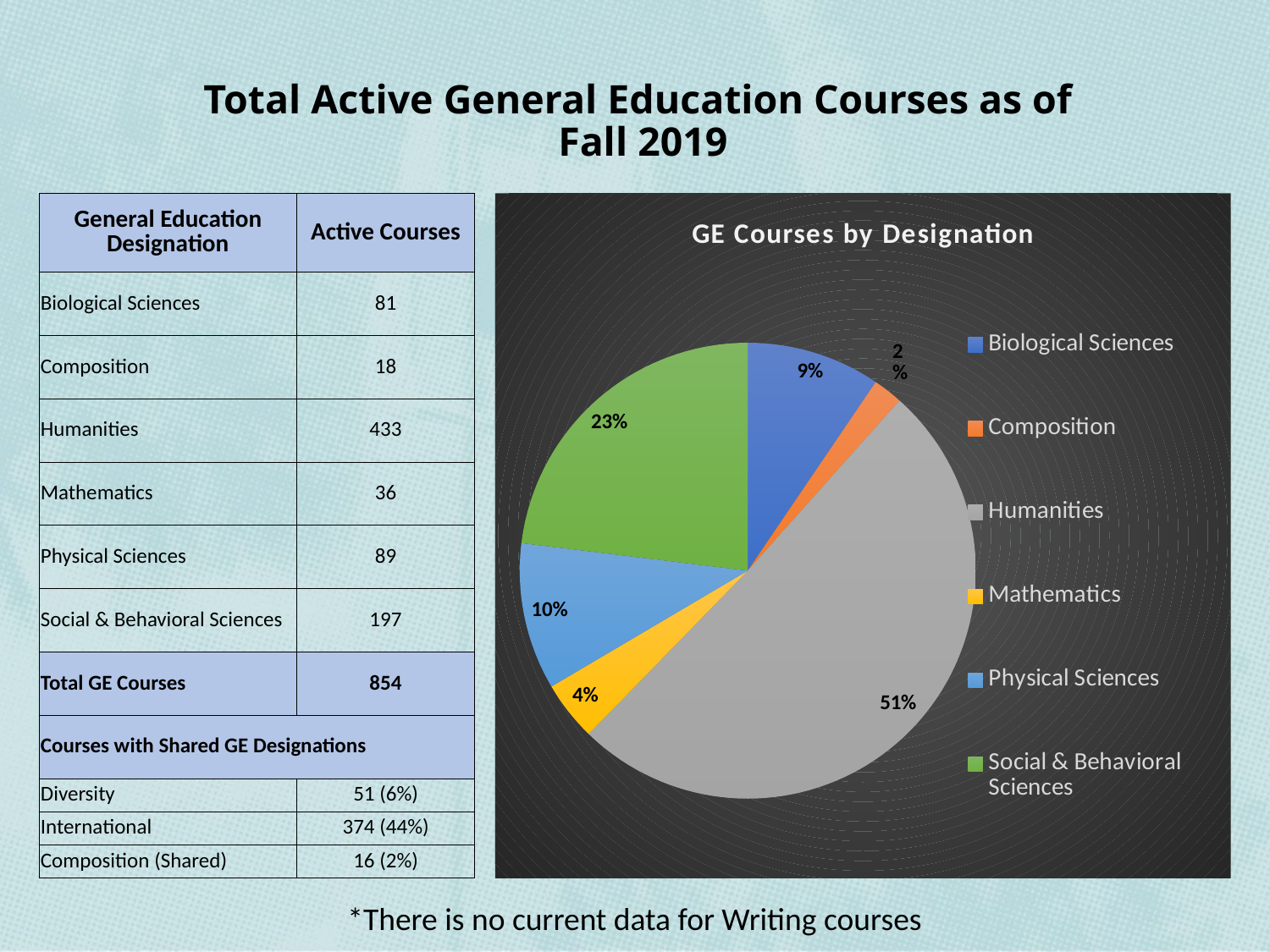
What share of the pie does Social & Behavioral Sciences represent? 23% What percentage is shown for Physical Sciences in the pie chart? 10% What share of the pie does Humanities represent? 51% What kind of chart is shown on the slide? Pie chart What percentage is shown for Mathematics in the pie chart? 4% How many categories does the legend of the pie chart list? 6 Which designation has the largest slice of the pie chart? Humanities What percentage is shown for Biological Sciences in the pie chart? 9% What is the title of the chart? GE Courses by Designation Which designation has the smallest slice of the pie chart? Composition What is the difference in percentage points between the Humanities slice and the Social & Behavioral Sciences slice? 28 Which slice is larger in the pie chart, Physical Sciences or Biological Sciences? Physical Sciences